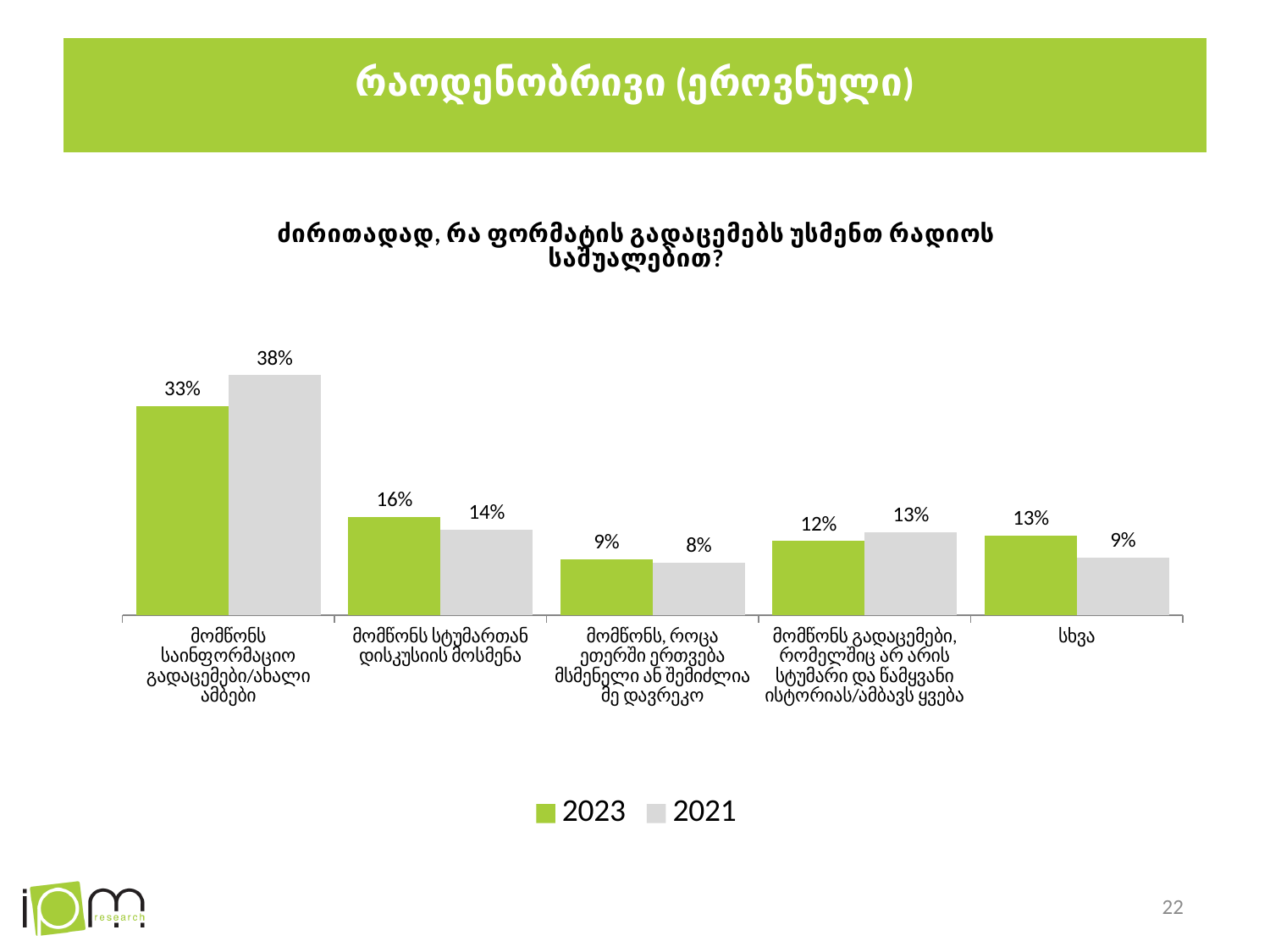
Which category has the lowest 2021 value? მომწონს, როცა ეთერში ერთვება მსმენელი ან შემიძლია მე დავრეკო What is the difference between the 2021 and 2023 values for "მომწონს საინფორმაციო გადაცემები/ახალი ამბები"? 5% How many categories are shown on the x axis? 5 What kind of chart is shown on the slide? Bar chart Which series is shown in green in the legend? 2023 Which category has the highest 2023 value? მომწონს საინფორმაციო გადაცემები/ახალი ამბები What is the 2021 value for "მომწონს სტუმართან დისკუსიის მოსმენა"? 14% For "სხვა", which year has the larger value, 2023 or 2021? 2023 What is the 2021 value for "მომწონს საინფორმაციო გადაცემები/ახალი ამბები"? 38% What is the 2023 value for "სხვა"? 13% What is the 2023 value for "მომწონს საინფორმაციო გადაცემები/ახალი ამბები"? 33% How many series does the legend list? 2